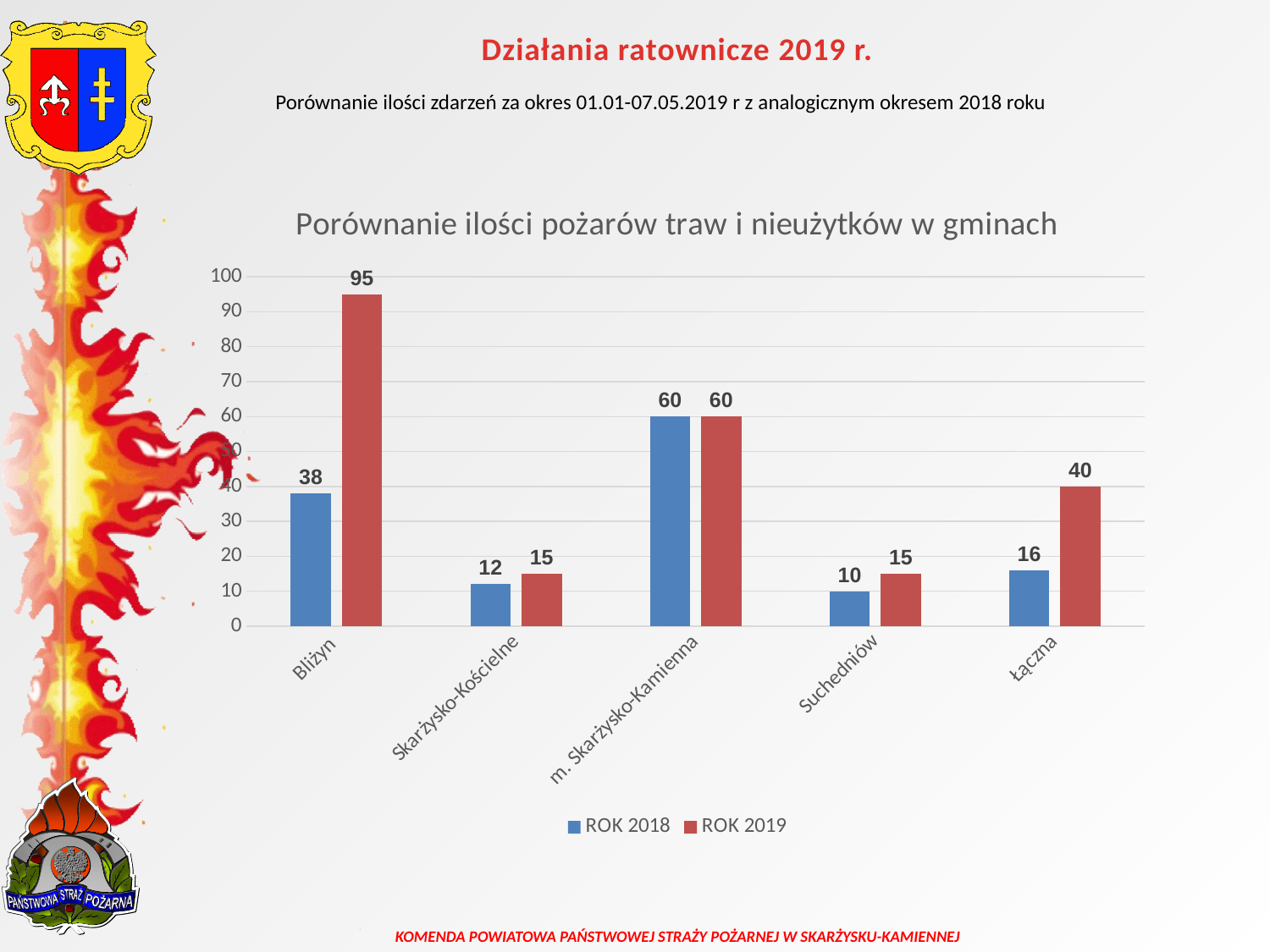
Which category has the highest ROK 2019 value? Bliżyn Which is larger in Skarżysko-Kościelne, ROK 2018 or ROK 2019? ROK 2019 Which category has the lowest ROK 2018 value? Suchedniów What is the value for ROK 2019 in Bliżyn? 95 What is the difference between ROK 2019 and ROK 2018 in Bliżyn? 57 How many categories (gminy) are shown on the x axis? 5 What is the value for ROK 2018 in Łączna? 16 What is the value for ROK 2018 in Suchedniów? 10 What is the title of the chart? Porównanie ilości pożarów traw i nieużytków w gminach How many series does the legend list? 2 What is the difference between ROK 2019 and ROK 2018 in Łączna? 24 What kind of chart is shown on the slide? bar chart